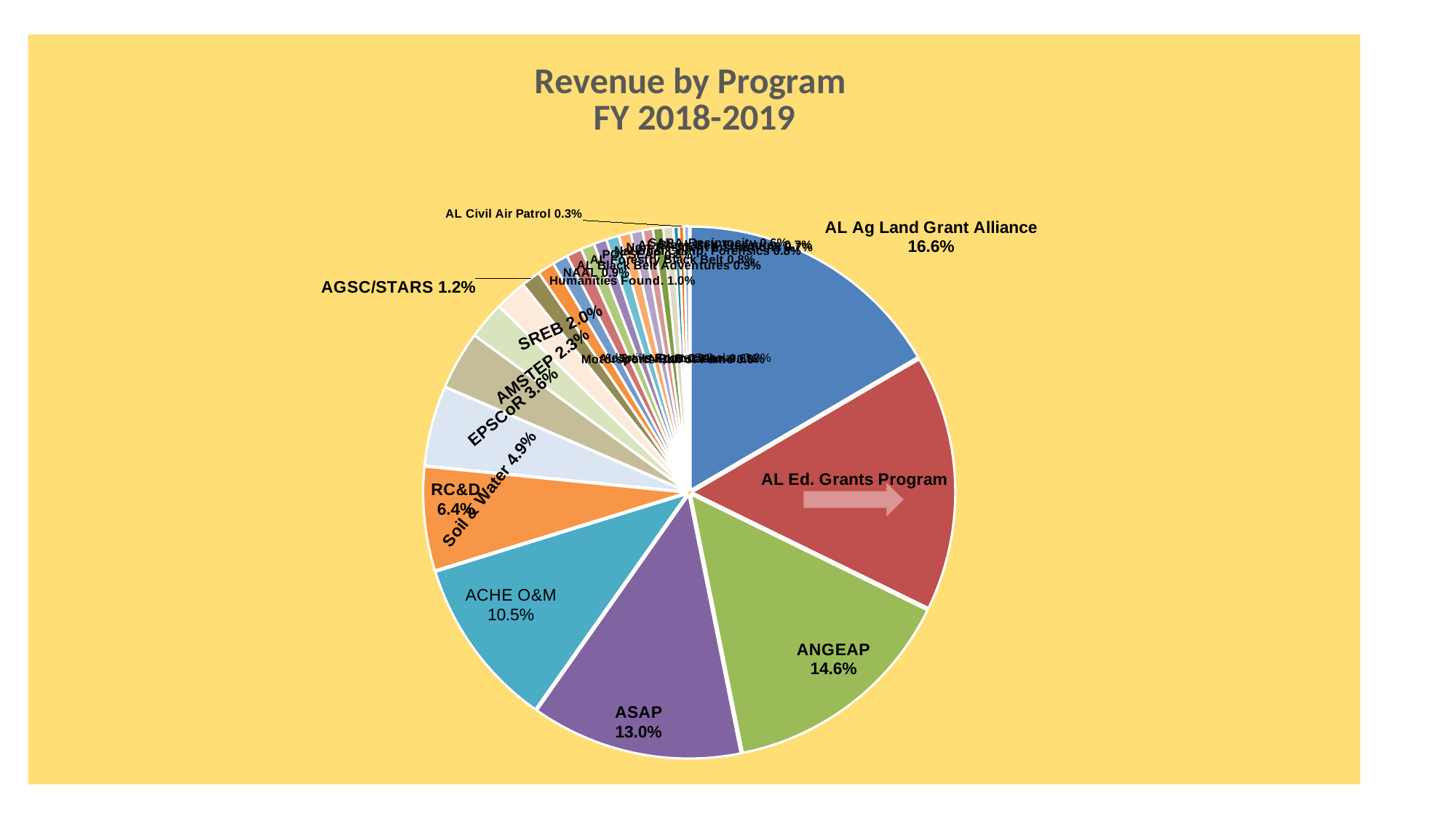
What is the title of the chart? Revenue by Program FY 2018-2019 What percentage is shown for ANGEAP? 14.6% Which has the larger share, ANGEAP or ASAP? ANGEAP What share of revenue does AL Ag Land Grant Alliance account for? 16.6% What is the difference in percentage points between ANGEAP and ASAP? 1.6 What percentage is shown for RC&D? 6.4% What kind of chart is shown on the slide? pie chart What percentage is shown for EPSCoR? 3.6% What is the difference in percentage points between AL Ag Land Grant Alliance and ACHE O&M? 6.1 What percentage is shown for ACHE O&M? 10.5% What percentage is shown for Soil & Water? 4.9% What percentage is shown for ASAP? 13.0%